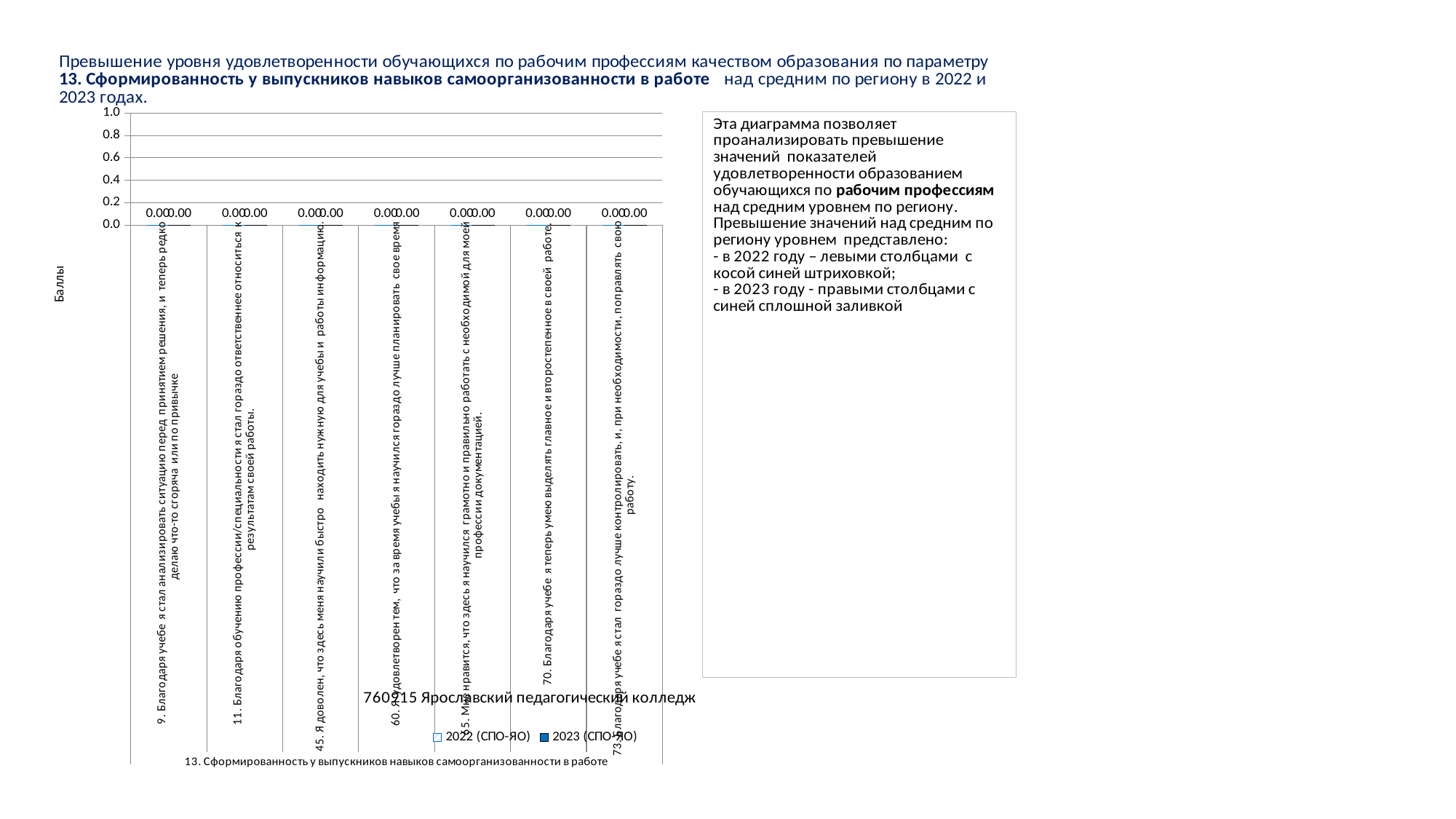
Is the value for 2022 (СПО-ЯО) for statement 60 greater or less than 0.2? less What is the value for 2023 (СПО-ЯО) for statement 73 ("Благодаря учебе я стал гораздо лучше контролировать... свою работу")? 0.00 What is the title of the vertical axis of the chart? Баллы What are the two series named in the chart legend? 2022 (СПО-ЯО) and 2023 (СПО-ЯО) How many categories (statements) are plotted along the x axis of the chart? 7 What is the value for 2022 (СПО-ЯО) for statement 9 ("Благодаря учебе я стал анализировать ситуацию перед принятием решения...")? 0.00 What is the highest tick value shown on the vertical axis of the chart? 1.0 What is the value for 2022 (СПО-ЯО) for statement 70 ("Благодаря учебе я теперь умею выделять главное и второстепенное в своей работе")? 0.00 What is the difference between the 2022 (СПО-ЯО) and 2023 (СПО-ЯО) values for statement 11? 0.00 What kind of chart is shown on the slide? bar chart What is the value for 2023 (СПО-ЯО) for statement 45 ("Я доволен, что здесь меня научили быстро находить нужную для учебы и работы информацию")? 0.00 How many series does the chart legend list? 2